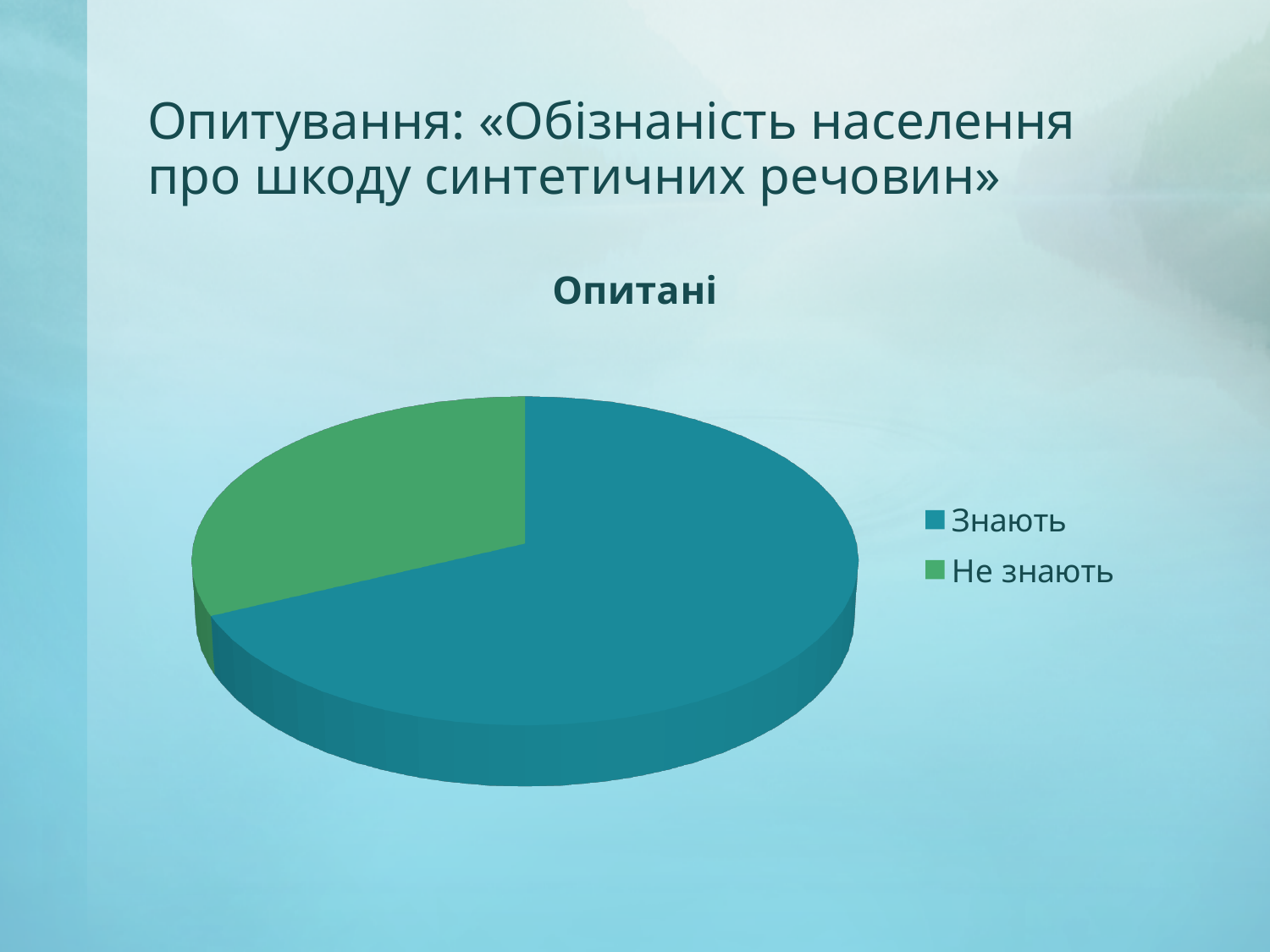
What is the title of the chart? Опитані How many slices does the pie chart have? 2 What kind of chart is shown on the slide? pie chart How many entries does the legend list? 2 Which category has the largest slice of the pie? Знають Which slice is larger, Знають or Не знають? Знають What colour is the slice for Не знають? green Which category has the smallest slice of the pie? Не знають